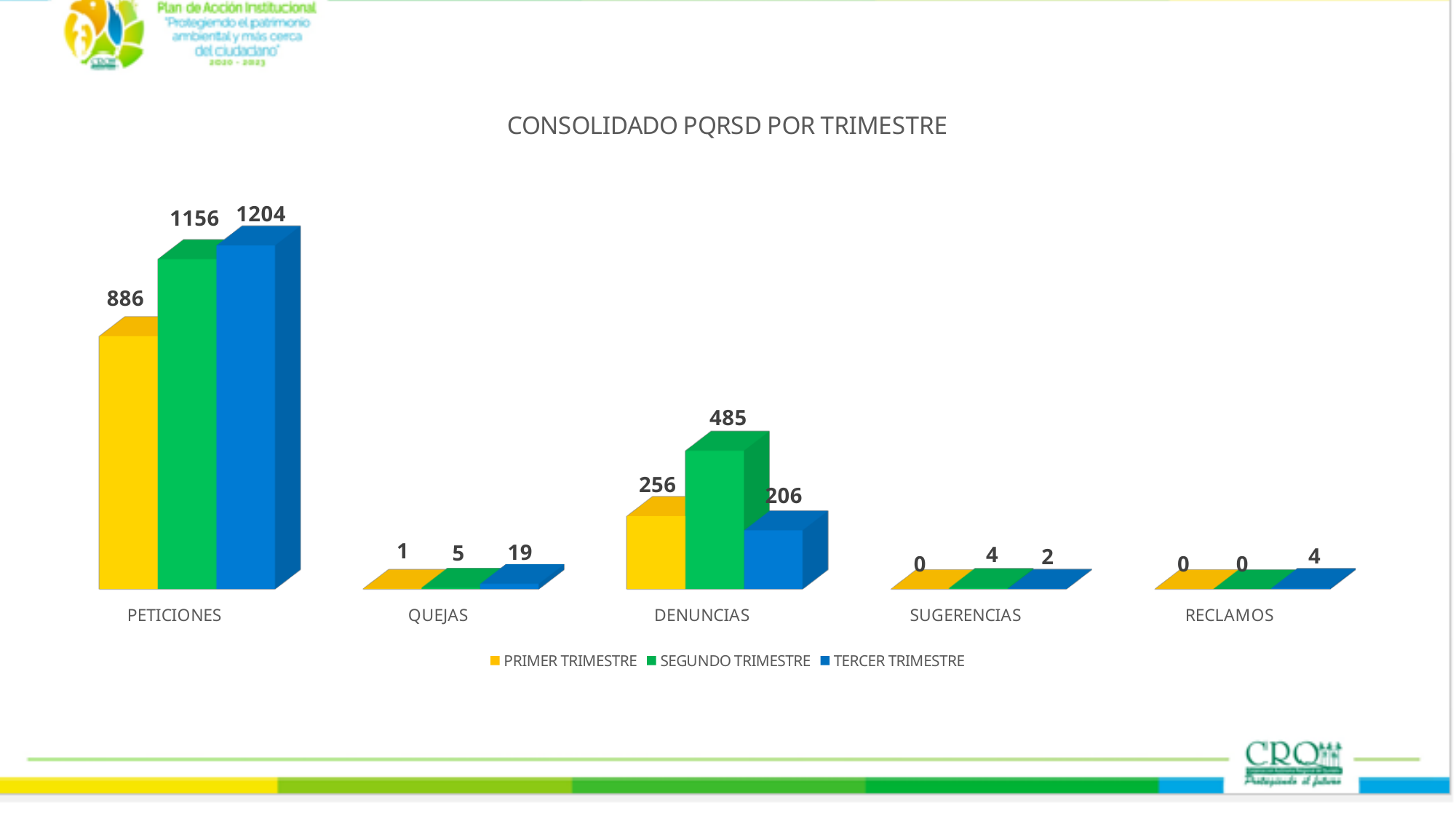
What is the value for QUEJAS in the TERCER TRIMESTRE series? 19 Which category has the highest value in the TERCER TRIMESTRE series? PETICIONES Which is larger for DENUNCIAS: the PRIMER TRIMESTRE value or the TERCER TRIMESTRE value? PRIMER TRIMESTRE How many categories are shown on the x axis? 5 What is the value for PETICIONES in the PRIMER TRIMESTRE series? 886 What is the difference between the TERCER TRIMESTRE and PRIMER TRIMESTRE values for PETICIONES? 318 What kind of chart is shown on the slide? Bar chart What is the total of the three series values for DENUNCIAS? 947 How many series does the legend list? 3 What is the value for DENUNCIAS in the SEGUNDO TRIMESTRE series? 485 Which category has the lowest value in the PRIMER TRIMESTRE series? SUGERENCIAS and RECLAMOS (both 0) What is the title of the chart? CONSOLIDADO PQRSD POR TRIMESTRE